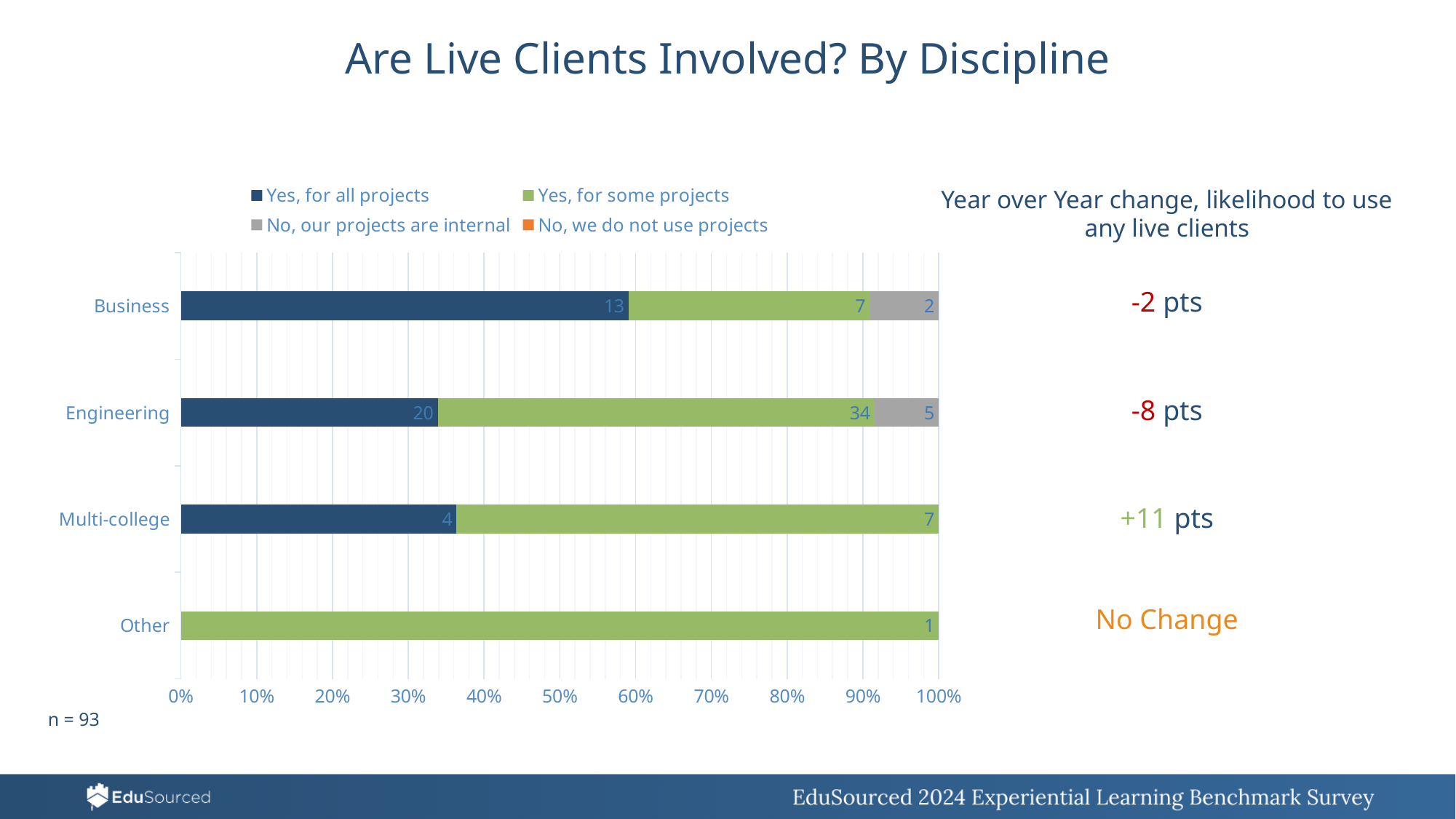
Which discipline has the largest "Yes, for some projects" count? Engineering What is the data label for "Yes, for all projects" in the Engineering bar? 20 Which discipline has the smallest "Yes, for all projects" count among those showing that segment? Multi-college What is the data label shown on the Other bar? 1 What is the difference between the "Yes, for all projects" counts for Engineering and Business? 7 What is the data label for "Yes, for some projects" in the Business bar? 7 What is the total of the data labels in the Engineering bar? 59 How many disciplines are shown on the y axis? 4 Is the "Yes, for all projects" share of the Business bar greater or less than 50%? greater What is the data label for "No, our projects are internal" in the Engineering bar? 5 Which is larger: the "Yes, for all projects" count for Business or the "Yes, for some projects" count for Business? Yes, for all projects How many series does the legend list? 4